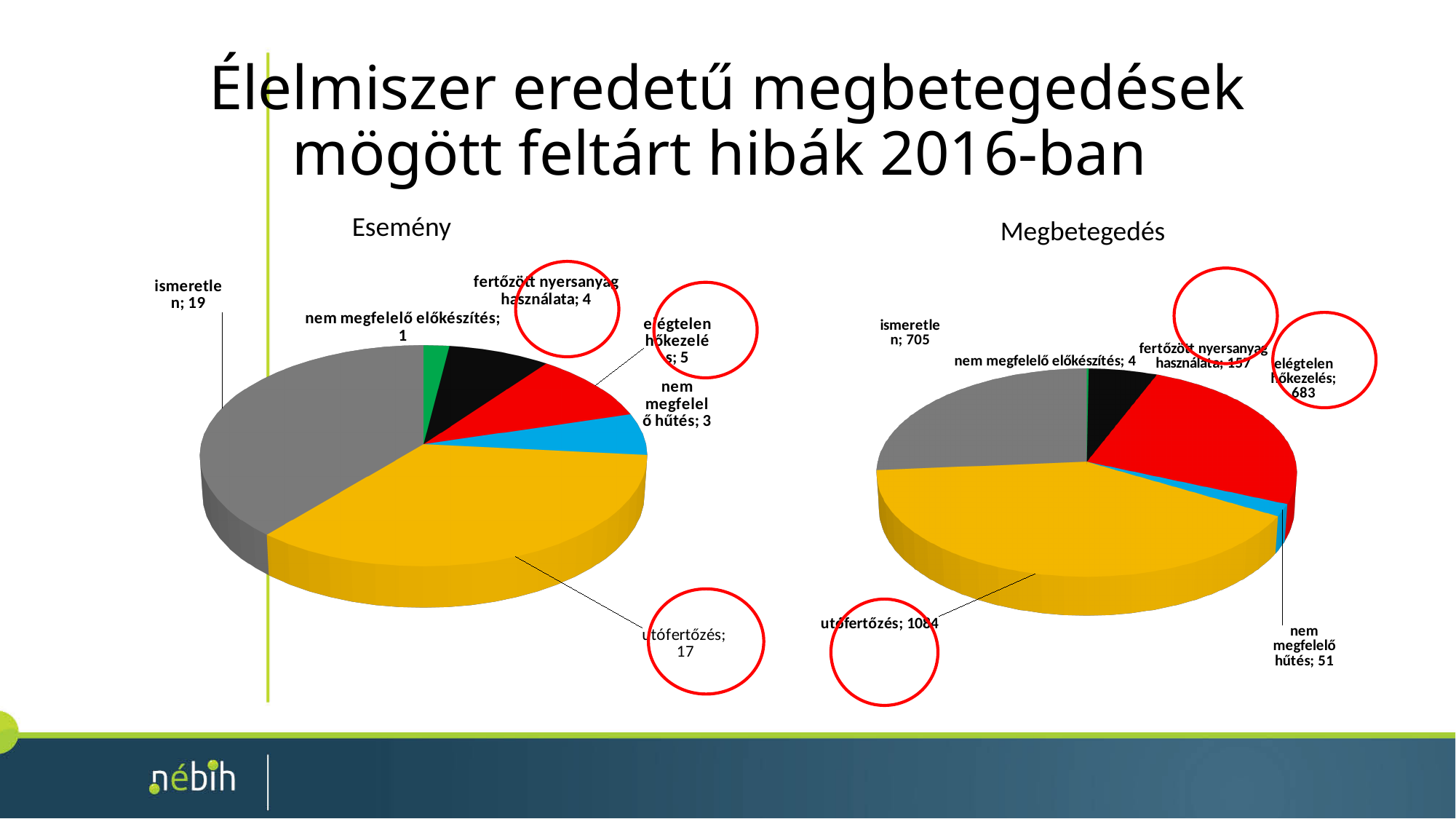
On the Megbetegedés chart, which category has the lowest value? nem megfelelő előkészítés On the Megbetegedés chart, what is the value for nem megfelelő hűtés? 51 On the Esemény chart, what is the value for utófertőzés? 17 On the Megbetegedés chart, what is the value for elégtelen hőkezelés? 683 On the Esemény chart, what is the value for ismeretlen? 19 How many slices does the Megbetegedés chart have? 6 On the Megbetegedés chart, what is the difference between utófertőzés and ismeretlen? 379 On the Esemény chart, which is larger: elégtelen hőkezelés or fertőzött nyersanyag használata? elégtelen hőkezelés On the Megbetegedés chart, which category has the highest value? utófertőzés What kind of chart is the Esemény chart? pie chart On the Esemény chart, which category has the lowest value? nem megfelelő előkészítés On the Esemény chart, what is the difference between ismeretlen and utófertőzés? 2